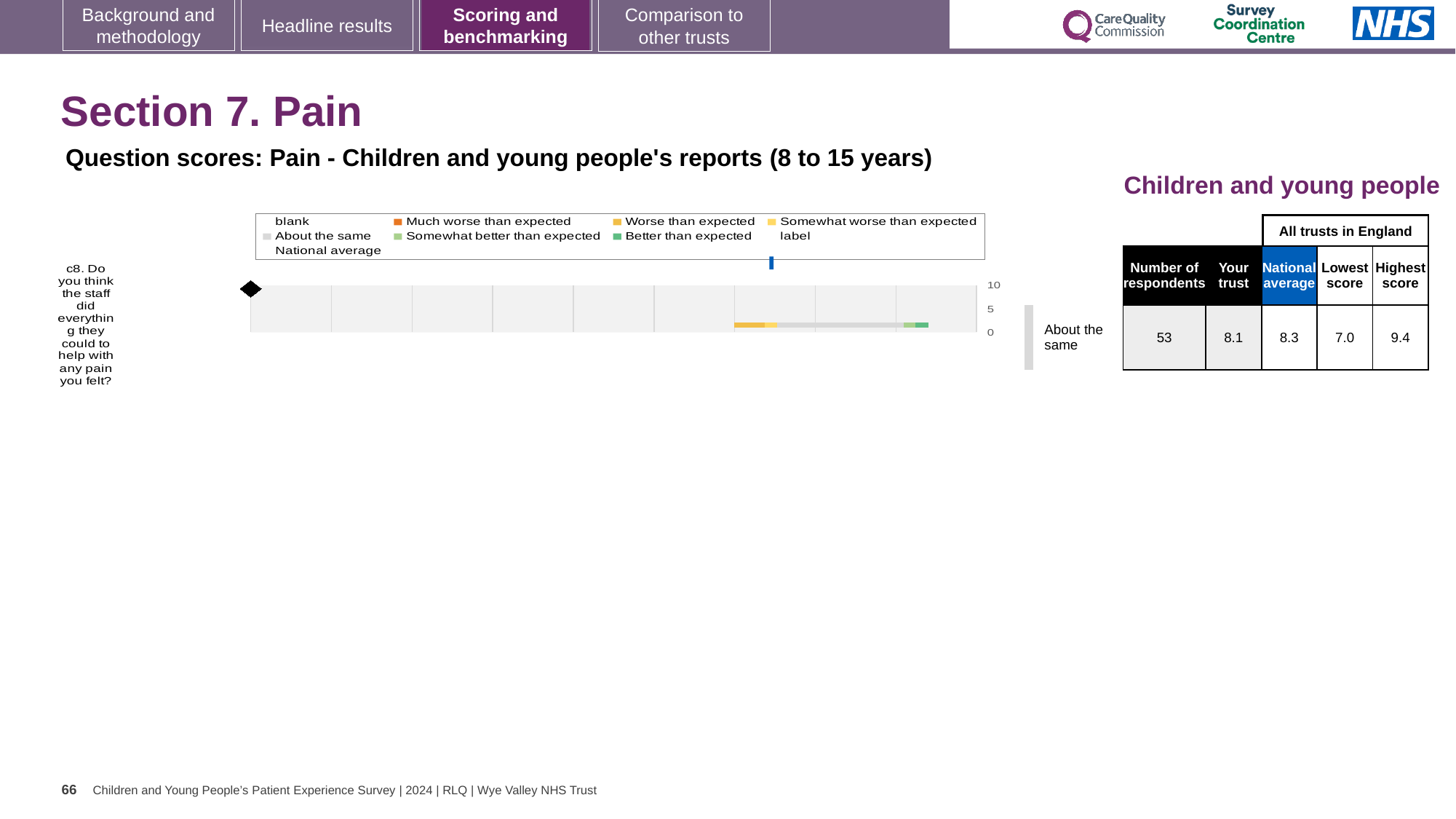
How many question categories are plotted in the chart? 1 What is the highest value shown on the chart's numeric axis? 10 Which legend entry is shown in orange in the chart? Much worse than expected What is the question number of the category plotted in the chart? c8 What kind of chart is shown on the slide? bar chart